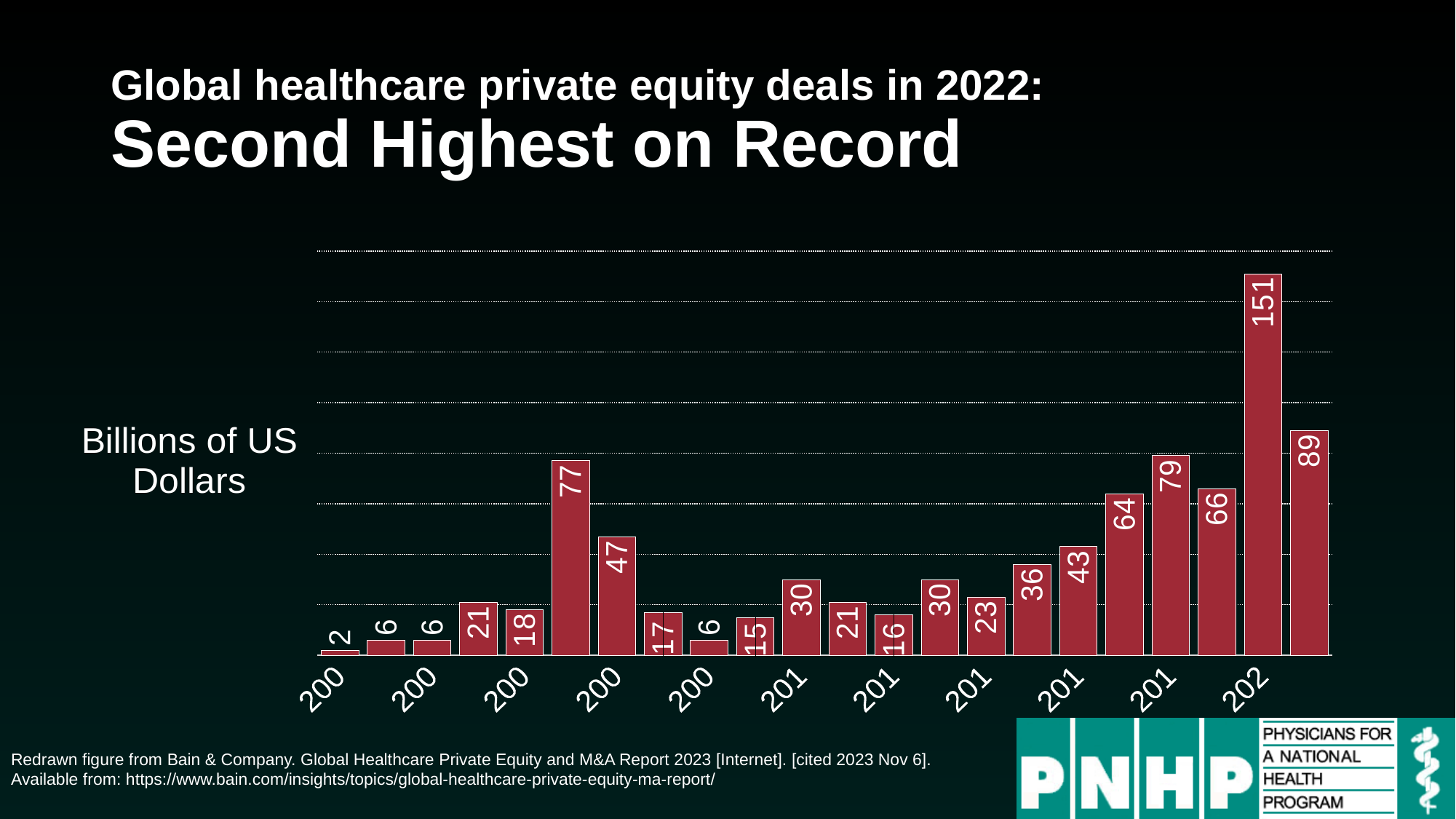
What is the difference between the tallest bar and the rightmost bar? 62 Which is larger, the sixth bar from the left or the rightmost bar? the rightmost bar (89) What is the value of the shortest bar in the chart? 2 Do the values generally rise or fall from left to right across the chart? rise What is the title of the slide? Global healthcare private equity deals in 2022: Second Highest on Record How many bars are plotted in the chart? 22 What is the value of the first (leftmost) bar in the chart? 2 What is the value of the last (rightmost) bar in the chart? 89 What is the value of the sixth bar from the left in the chart? 77 What is the value of the tallest bar in the chart? 151 What kind of chart is shown on the slide? bar chart What is the label on the vertical axis of the chart? Billions of US Dollars